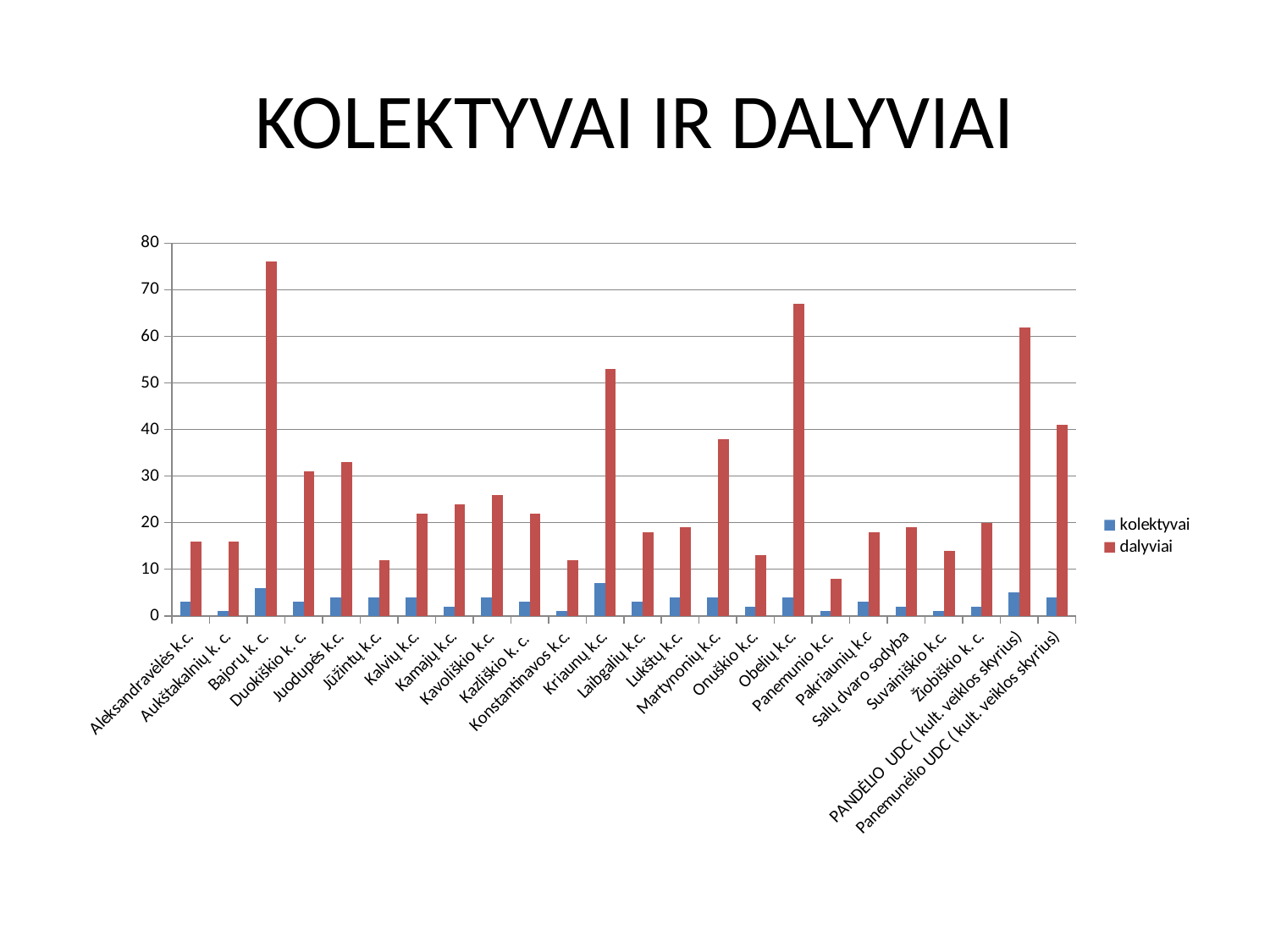
How many categories are shown on the x axis? 24 What kind of chart is shown on the slide? bar chart Which has the larger dalyviai value, Obelių k.c. or Kriaunų k.c.? Obelių k.c. Is the dalyviai value for Panemunio k.c. greater or less than 10? less Is the dalyviai value for Kavoliškio k.c. greater or less than 20? greater Is the dalyviai value for Obelių k.c. greater or less than 60? greater How many series does the legend list? 2 Which category has the lowest dalyviai value? Panemunio k.c. What is the title of the slide? KOLEKTYVAI IR DALYVIAI Which category has the highest dalyviai value? Bajorų k. c. What are the two series named in the legend? kolektyvai and dalyviai